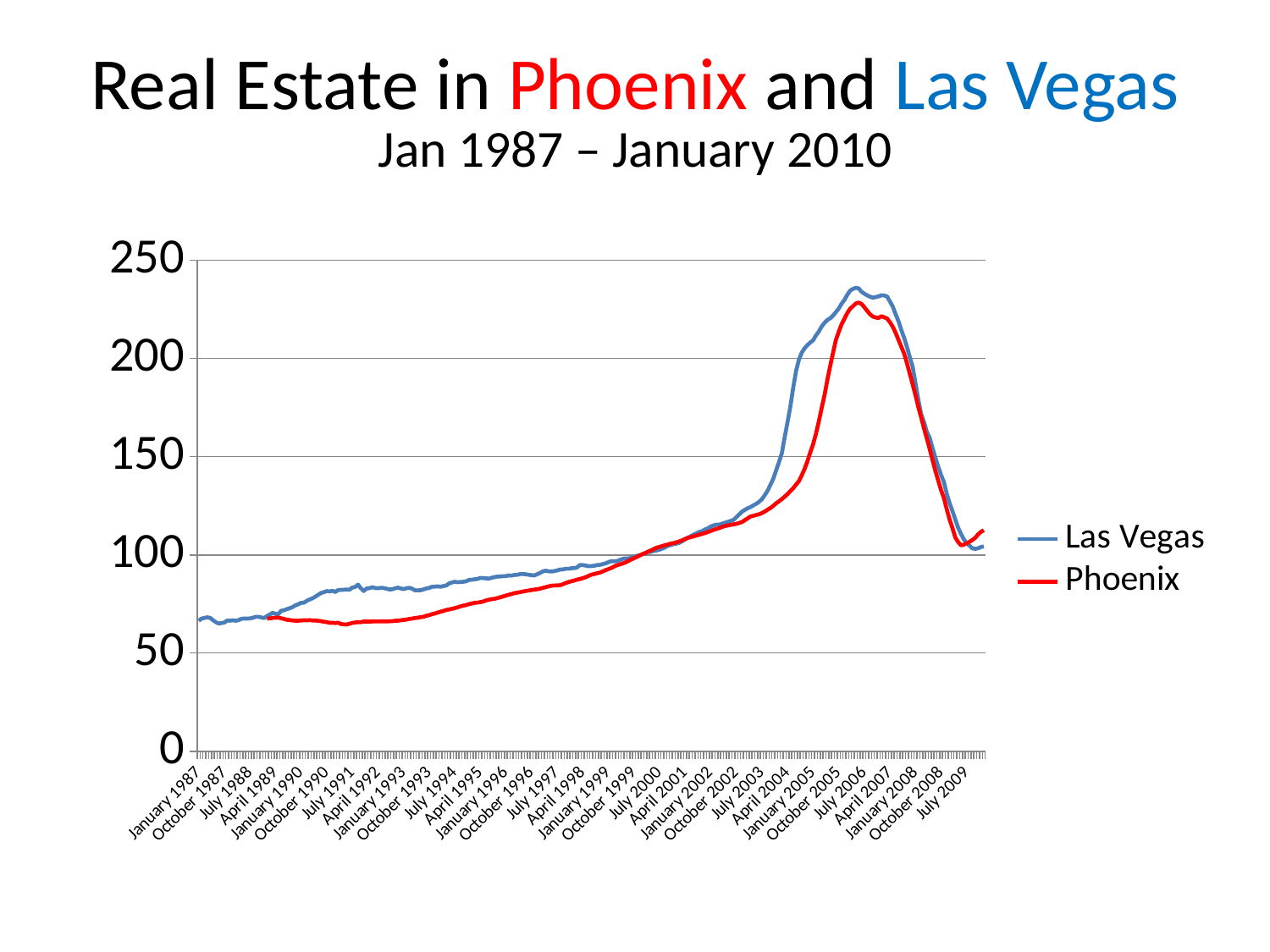
Do the values of both series rise or fall between January 2007 and January 2009? fall What is the title of the chart on the slide? Real Estate in Phoenix and Las Vegas Which colour is used for the Phoenix line? red Is the Phoenix value in July 2004 greater or less than 150? less Is the peak value of the Las Vegas line greater or less than 200? greater What kind of chart is shown on the slide? line chart Is the Las Vegas value in January 1987 greater or less than 100? less In January 1992, which series has the higher value, Las Vegas or Phoenix? Las Vegas Which series reaches the higher peak, Las Vegas or Phoenix? Las Vegas How many series does the legend list? 2